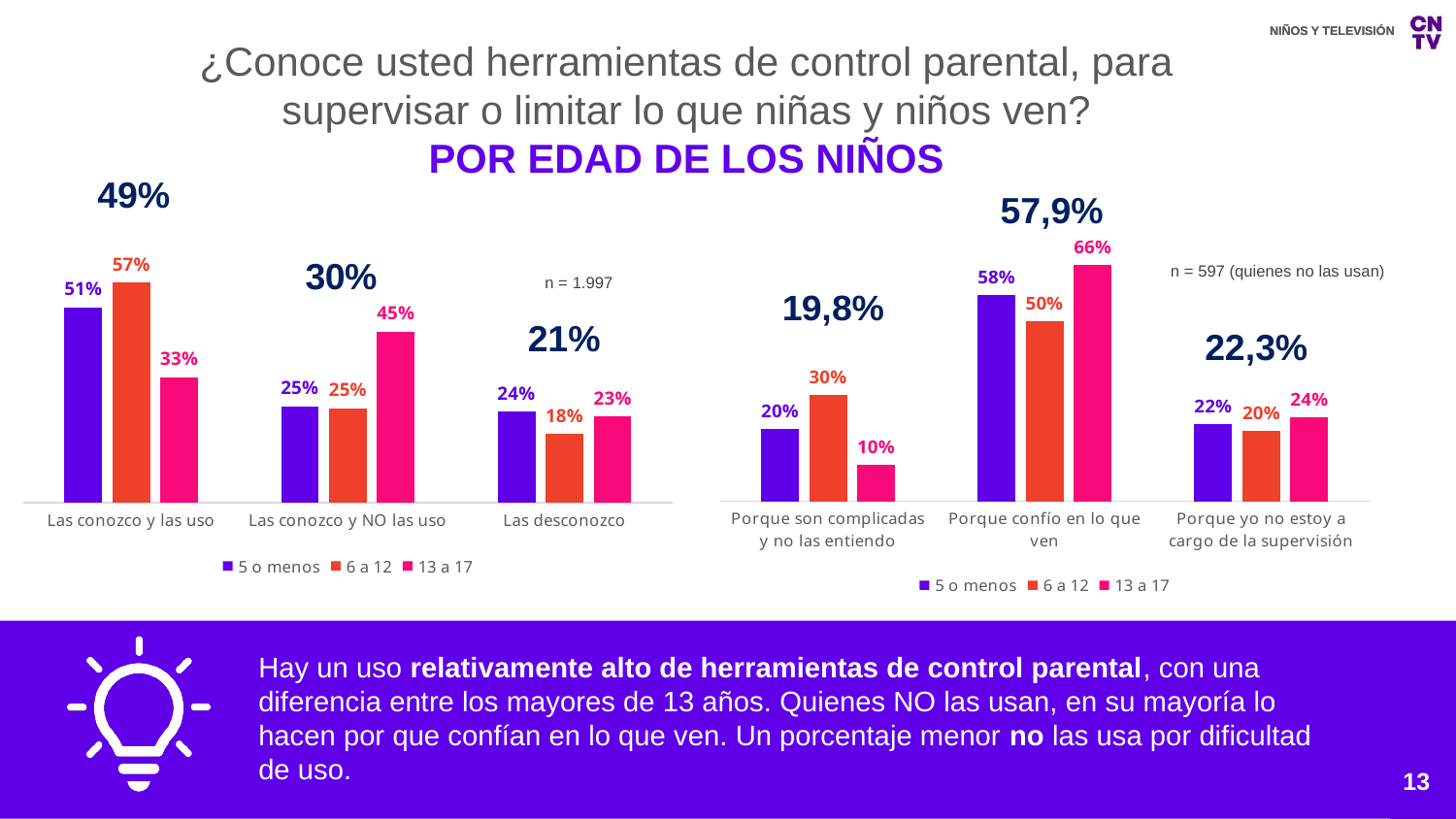
In the right chart, what is the value for '13 a 17' in the category 'Porque confío en lo que ven'? 66% In the left chart, what is the difference between the '6 a 12' and '13 a 17' values in the category 'Las conozco y las uso'? 24% In the right chart, what is the value for '5 o menos' in the category 'Porque son complicadas y no las entiendo'? 20% In the right chart, which age group has the lowest value in the category 'Porque son complicadas y no las entiendo'? 13 a 17 In the left chart, what is the value for '6 a 12' in the category 'Las desconozco'? 18% In the right chart, what is the difference between the '13 a 17' and '6 a 12' values in the category 'Porque confío en lo que ven'? 16% What type of chart is the left chart? Bar chart In the left chart, what is the value for '13 a 17' in the category 'Las conozco y las uso'? 33% In the right chart, which is larger: the '5 o menos' value or the '6 a 12' value in the category 'Porque confío en lo que ven'? 5 o menos How many categories are shown on the x axis of the right chart? 3 How many series does the legend of the left chart list? 3 In the left chart, which age group has the highest value in the category 'Las conozco y NO las uso'? 13 a 17